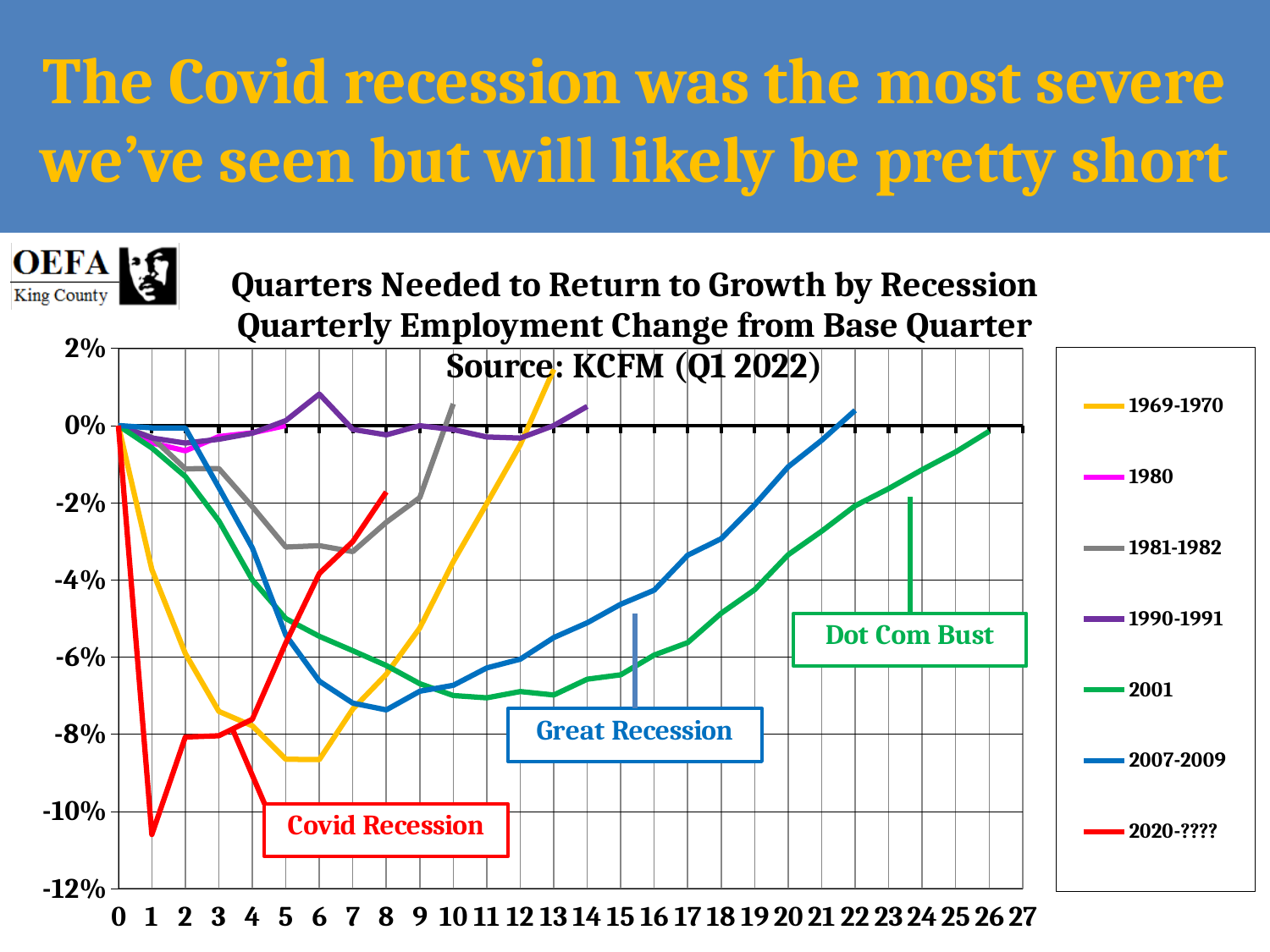
Is the value for the 1981-1982 series at quarter 5 greater or less than -2%? less Is the value for the 1969-1970 series at quarter 5 greater or less than -8%? less How many series does the legend list? 7 Is the value for the 1990-1991 series at quarter 6 greater or less than 0%? greater What kind of chart is shown on the slide? line chart At quarter 5, which series has the higher value: 1969-1970 or 2001? 2001 Which series takes the most quarters to return to 0%? 2001 What source is cited in the chart title? KCFM (Q1 2022) Which series is labelled 'Dot Com Bust' on the chart? 2001 Which recession series reaches the lowest employment change on the chart? 2020-????